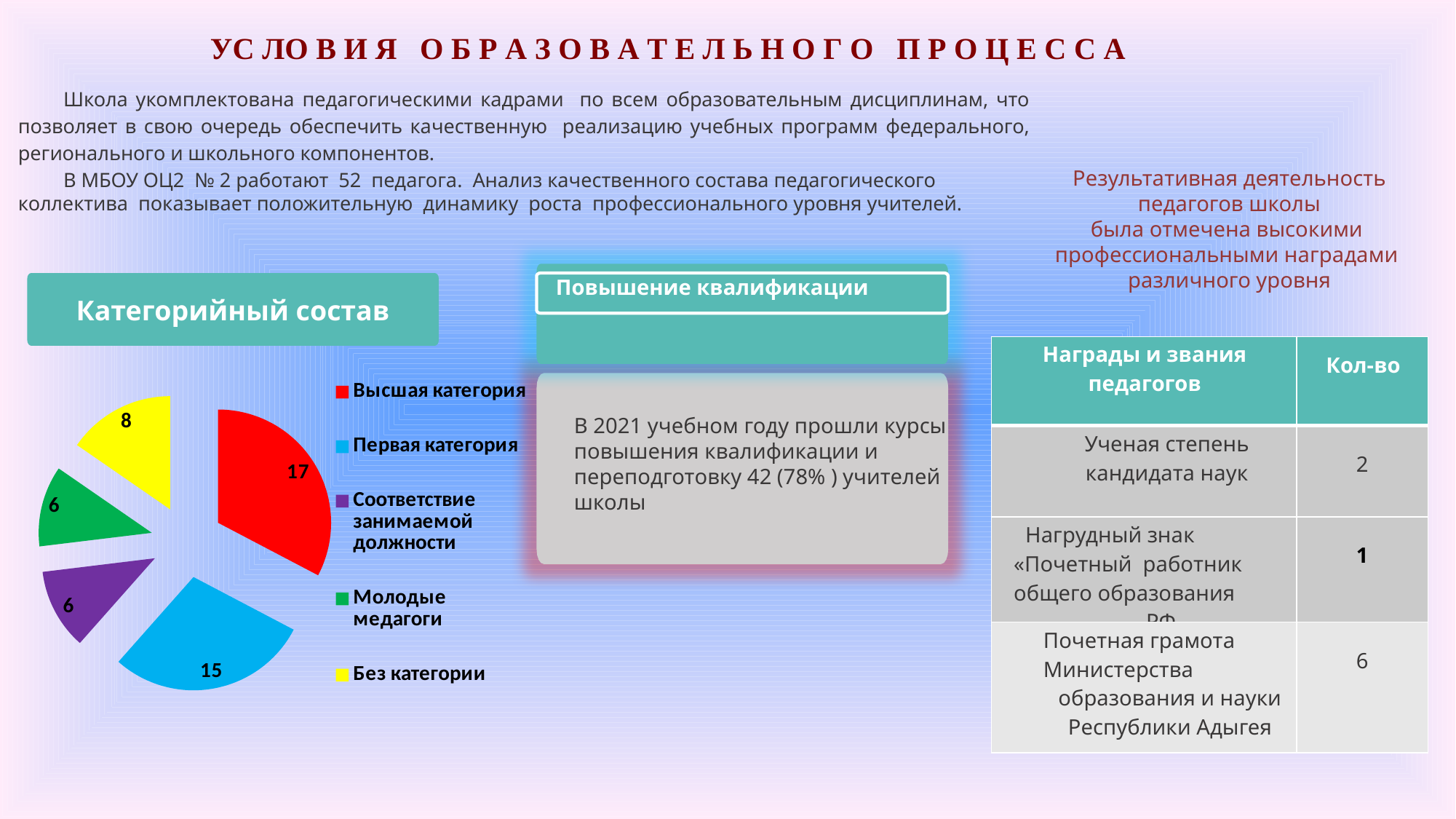
In the "Категорийный состав" pie chart, what is the value for "Без категории"? 8 What is the total of all slice values in the "Категорийный состав" pie chart? 52 In the "Категорийный состав" pie chart, which colour represents "Соответствие занимаемой должности"? purple In the "Категорийный состав" pie chart, what is the value for "Первая категория"? 15 Which category has the largest slice in the "Категорийный состав" pie chart? Высшая категория In the "Категорийный состав" pie chart, what is the difference between the values for "Высшая категория" and "Первая категория"? 2 How many slices does the "Категорийный состав" pie chart have? 5 In the "Категорийный состав" pie chart, what share of the total does "Без категории" represent? 15.4% In the "Категорийный состав" pie chart, which is larger: "Без категории" or "Молодые педагоги"? Без категории In the "Категорийный состав" pie chart, what is the value for "Молодые педагоги"? 6 In the "Категорийный состав" pie chart, what is the value for "Высшая категория"? 17 What kind of chart is shown under the heading "Категорийный состав"? pie chart